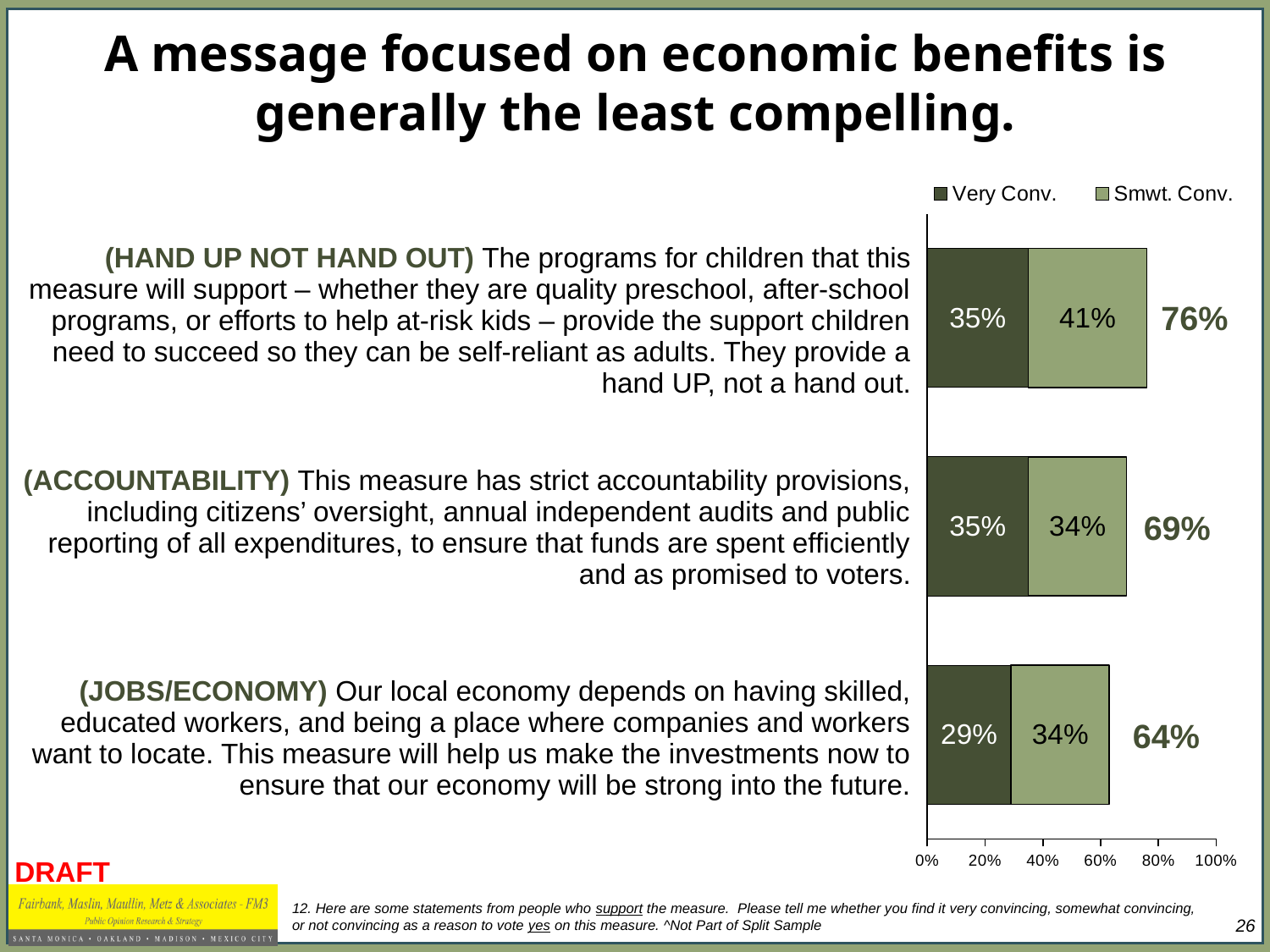
Which message has the highest combined convincing total? HAND UP NOT HAND OUT Which message has a larger 'Very Conv.' share: ACCOUNTABILITY or JOBS/ECONOMY? ACCOUNTABILITY What percentage found the JOBS/ECONOMY message somewhat convincing? 34% What are the two legend entries in the chart? Very Conv. and Smwt. Conv. Which message has the lowest combined convincing total? JOBS/ECONOMY What is the combined total (very plus somewhat convincing) for the ACCOUNTABILITY message? 69% How many messages are shown in the chart? 3 What percentage found the HAND UP NOT HAND OUT message very convincing? 35% What kind of chart is shown on the slide? Stacked bar chart What is the difference between the combined totals for HAND UP NOT HAND OUT and JOBS/ECONOMY? 12% How many series does the legend list? 2 Is the combined total for the JOBS/ECONOMY message greater or less than 60%? greater